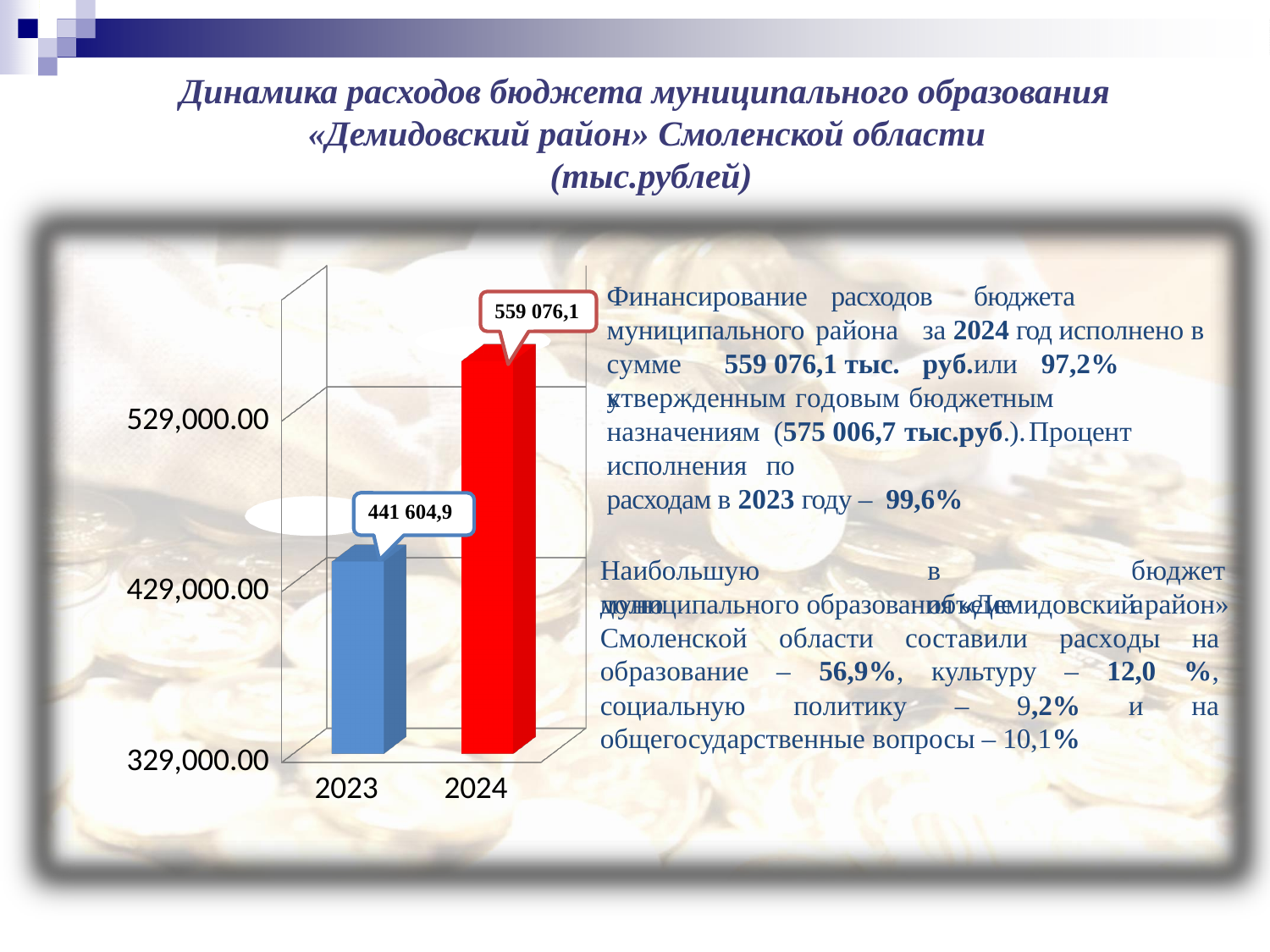
In what units are the values on the chart expressed, according to the slide title? тыс.рублей What kind of chart is shown on the slide? Bar chart Which year has the lowest value? 2023 Is the value for 2024 greater or less than 529,000.00? greater Which year has the highest value? 2024 What is the value shown for 2023? 441 604,9 What is the difference between the values for 2024 and 2023? 117 471,2 What is the value shown for 2024? 559 076,1 Do the values rise or fall from 2023 to 2024? Rise Which is larger, the value for 2023 or the value for 2024? 2024 Is the value for 2023 greater or less than 429,000.00? greater How many years are shown on the x axis? 2